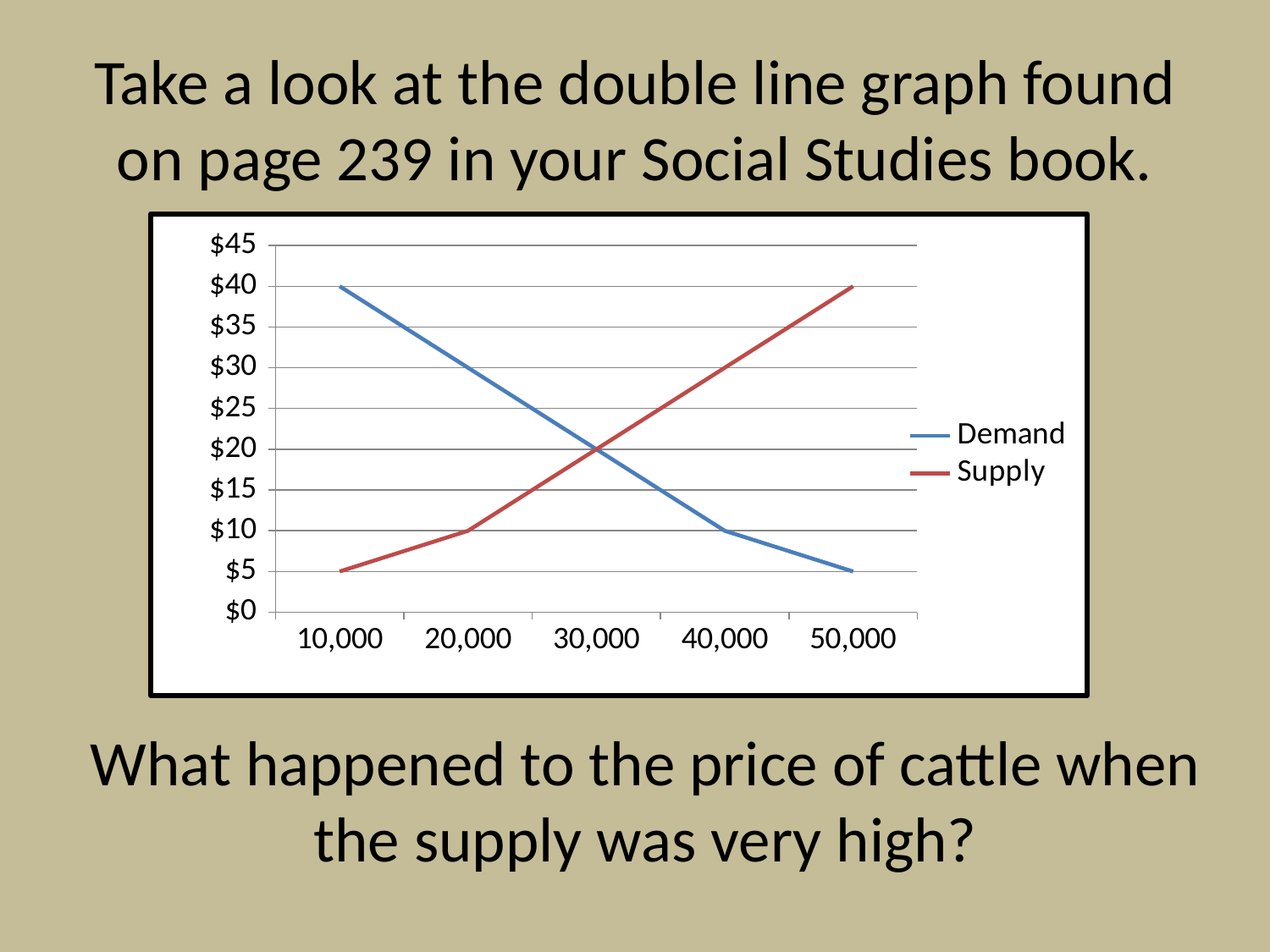
What kind of chart is shown on the slide? line chart How many series does the legend list? 2 What is the Demand value at 10,000? $40 Does the Demand line rise or fall as the x axis increases from 10,000 to 50,000? fall Is the Demand value at 20,000 greater or less than $25? greater At 40,000, which is larger, Demand or Supply? Supply Does the Supply line rise or fall as the x axis increases from 10,000 to 50,000? rise What is the Supply value at 10,000? $5 How many points are plotted along the x axis for each line? 5 What is the Demand value at 50,000? $5 What are the two series named in the legend? Demand and Supply What is the Supply value at 50,000? $40